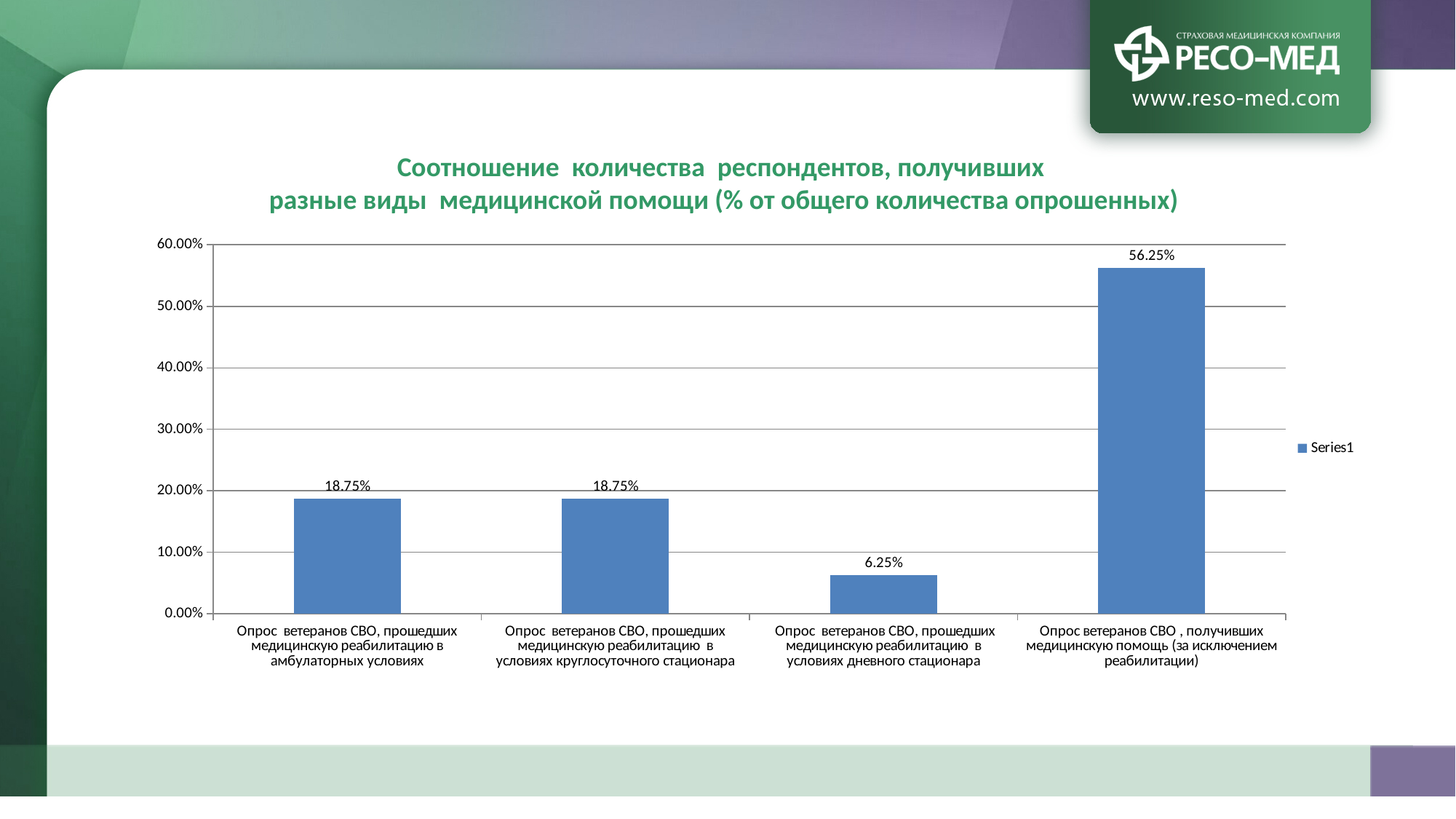
What is the value for respondents who received medical rehabilitation in a 24-hour hospital (круглосуточного стационара)? 18.75% Which category has the lowest value? Опрос ветеранов СВО, прошедших медицинскую реабилитацию в условиях дневного стационара Which category has the highest value? Опрос ветеранов СВО, получивших медицинскую помощь (за исключением реабилитации) Which is larger: the value for rehabilitation in outpatient conditions or the value for rehabilitation in a day hospital? Rehabilitation in outpatient conditions (амбулаторных условиях) How many categories are shown on the chart? 4 What is the value for respondents who received medical care excluding rehabilitation (за исключением реабилитации)? 56.25% What kind of chart is shown on the slide? Bar chart Is the value for medical care excluding rehabilitation greater or less than 50.00%? greater What is the difference between the value for medical care excluding rehabilitation (56.25%) and the value for rehabilitation in a day hospital (6.25%)? 50.00% What is the value for respondents who received medical rehabilitation in outpatient conditions (амбулаторных условиях)? 18.75% How many series does the legend list? 1 What is the value for respondents who received medical rehabilitation in a day hospital (дневного стационара)? 6.25%